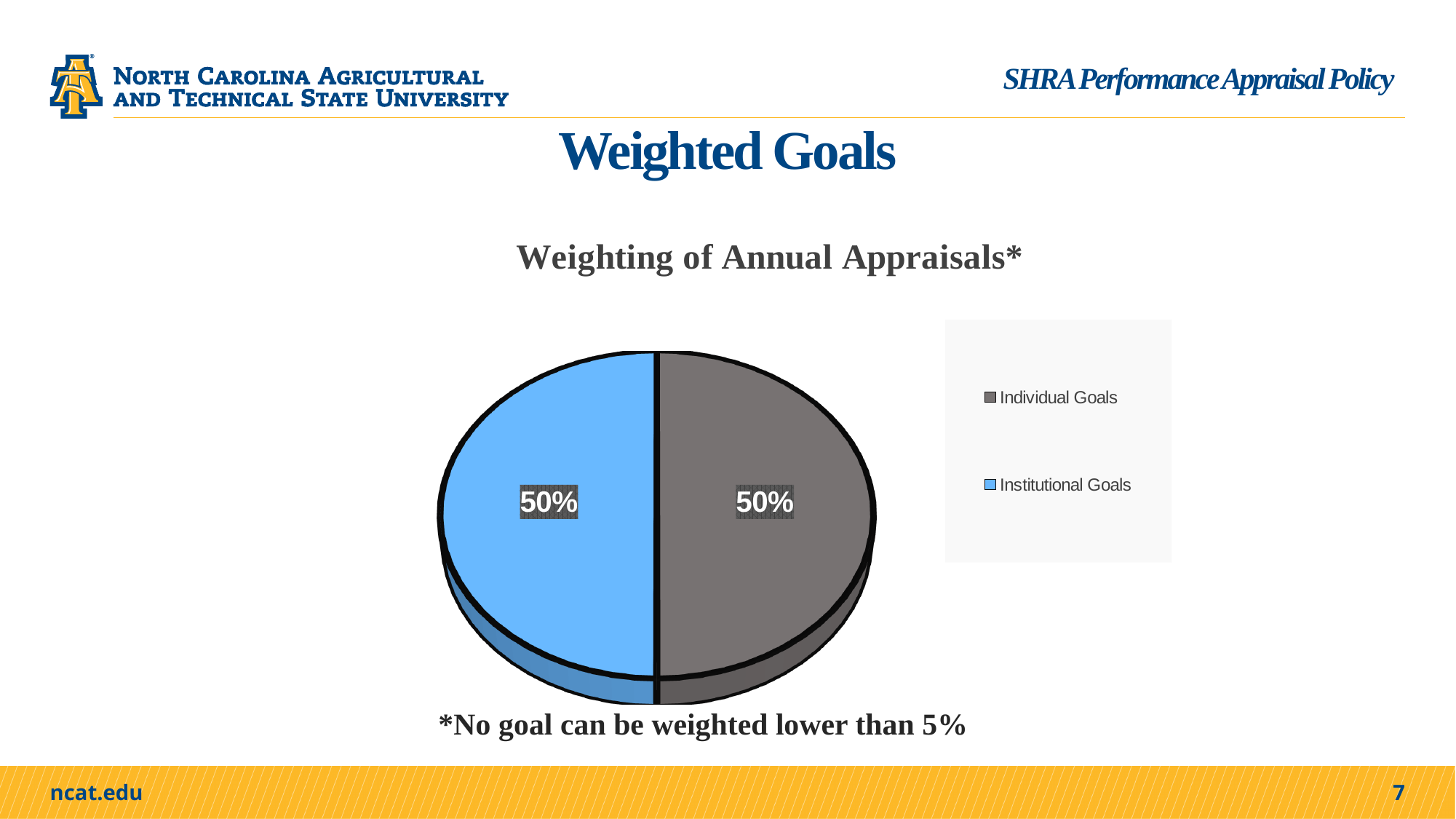
What share of the pie is Institutional Goals? 50% How many entries does the legend list? 2 What is the total of the two slices in the pie chart? 100% What is the difference between the Individual Goals share and the Institutional Goals share? 0% What kind of chart is shown on the slide? pie chart How many slices does the pie chart have? 2 What share of the pie is Individual Goals? 50% Is the value for Individual Goals greater or less than 5%? greater What is the title of the chart? Weighting of Annual Appraisals* Which legend entry is shown in blue? Institutional Goals